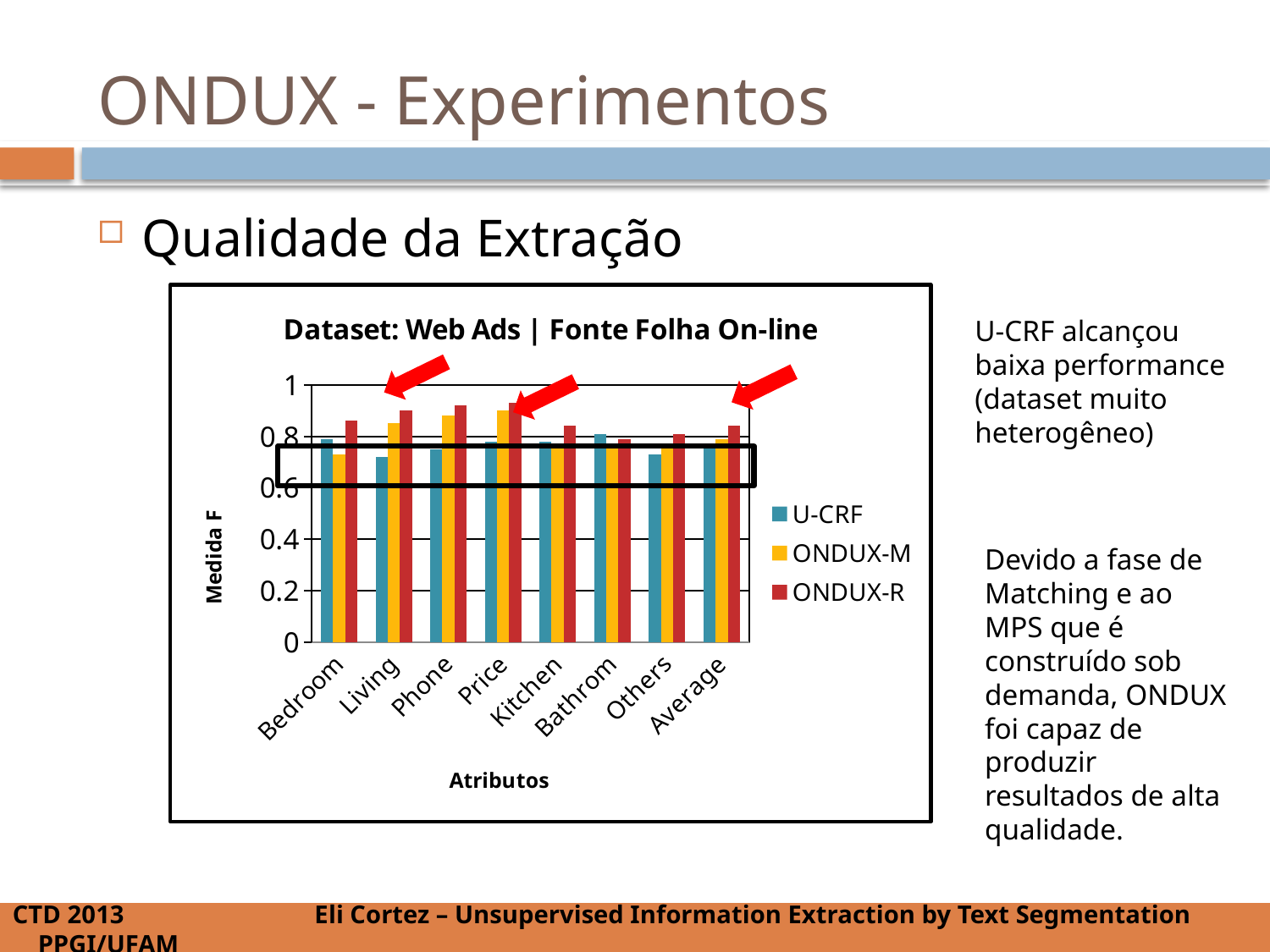
What kind of chart is shown on the slide? bar chart Is the U-CRF value for Living greater or less than 0.8? less How many categories are shown on the x axis of the chart? 8 Is the ONDUX-R value for Living greater or less than 0.8? greater What is the label of the vertical axis of the chart? Medida F For the Living category, which series has the larger value, U-CRF or ONDUX-R? ONDUX-R Is the ONDUX-R value for Phone greater or less than 0.8? greater For the Price category, which series has the larger value, U-CRF or ONDUX-M? ONDUX-M What is the title of the chart? Dataset: Web Ads | Fonte Folha On-line How many series does the legend of the chart list? 3